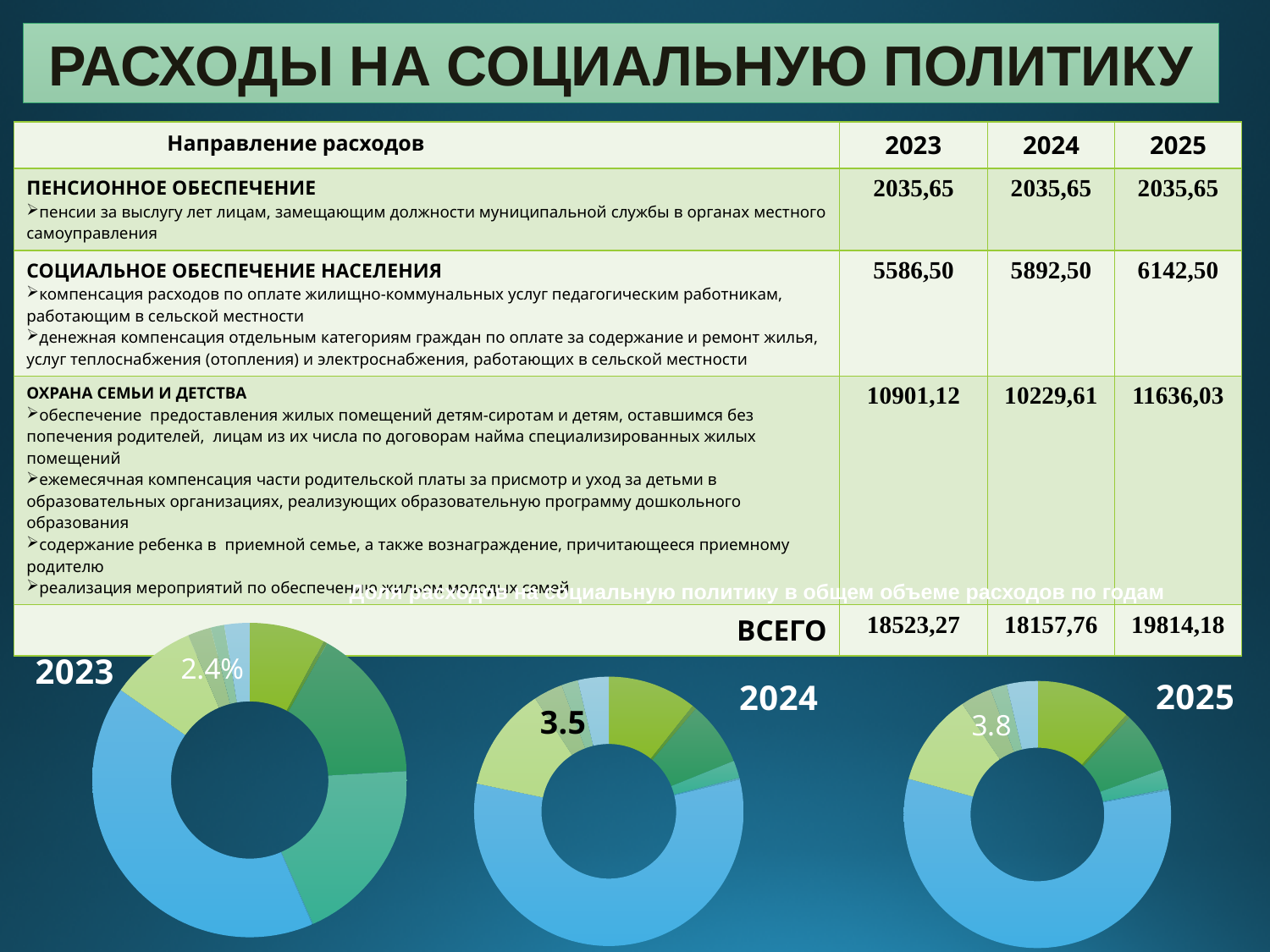
Does the labelled share of social policy spending rise or fall from the 2023 chart to the 2025 chart? Rises Which year's doughnut chart shows the lowest labelled share of social policy spending? 2023 What is the title printed above the doughnut charts? Доля расходов на социальную политику в общем объеме расходов по годам Which year's doughnut chart shows the highest labelled share of social policy spending? 2025 In the 2024 doughnut chart, what value is printed as the data label? 3.5 In the 2023 doughnut chart, what value is printed as the data label? 2.4% In the 2025 doughnut chart, what value is printed as the data label? 3.8 Is the labelled share in the 2024 doughnut chart larger or smaller than the labelled share in the 2025 doughnut chart? Smaller What kind of chart is used to show the share of social policy spending for each year? Doughnut chart Which years are the three doughnut charts labelled with? 2023, 2024, 2025 How many doughnut charts are shown on the slide? 3